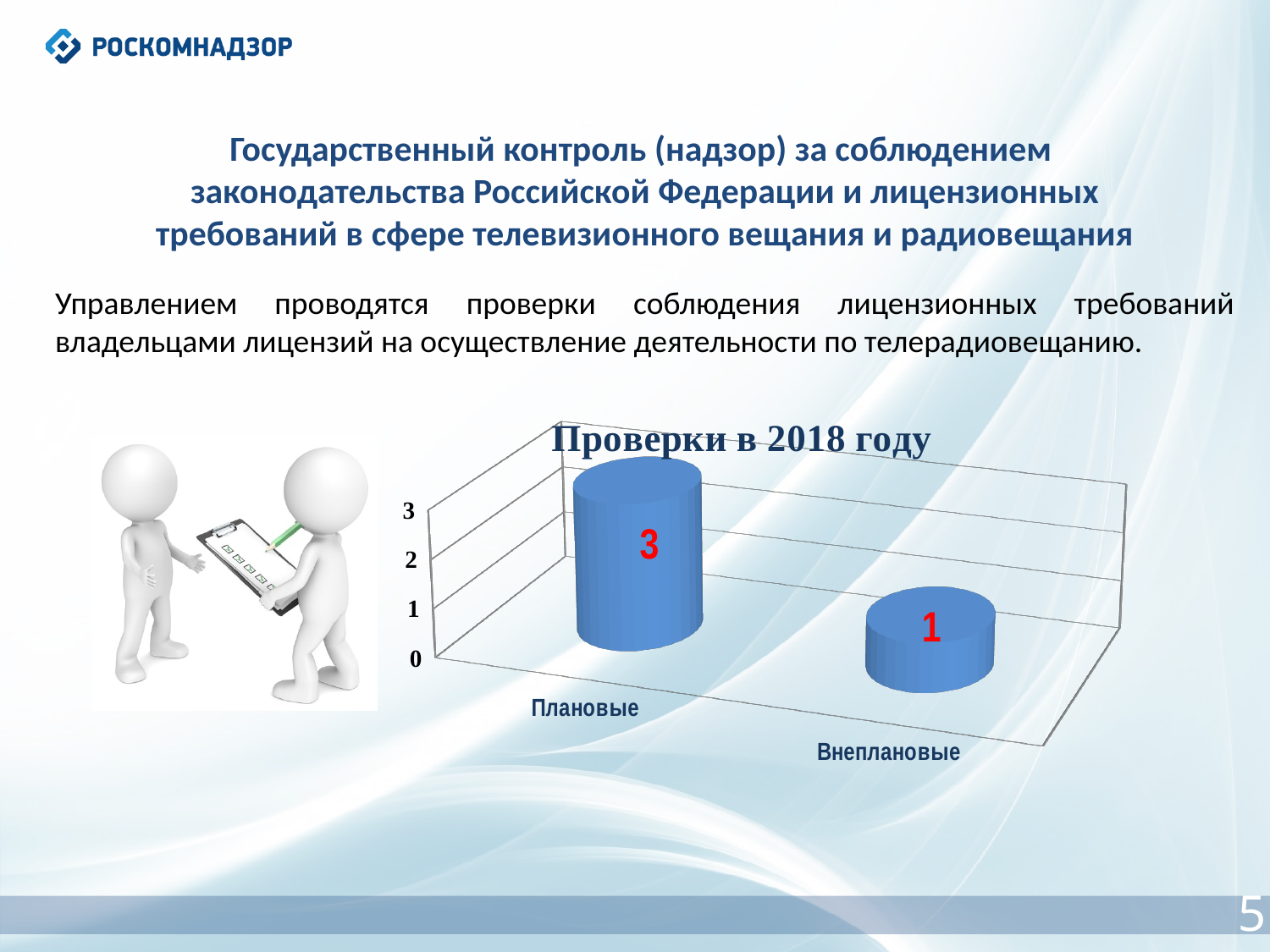
Which category has the lowest value? Внеплановые What is the title of the chart? Проверки в 2018 году What is the highest value shown on the vertical axis of the chart? 3 What is the value for Плановые? 3 How many categories are shown in the chart? 2 Is the value for Плановые greater or less than 2? greater Which is larger, the value for Плановые or the value for Внеплановые? Плановые What is the value for Внеплановые? 1 What is the difference between the values for Плановые and Внеплановые? 2 Which category has the highest value? Плановые What kind of chart is shown on the slide? bar chart